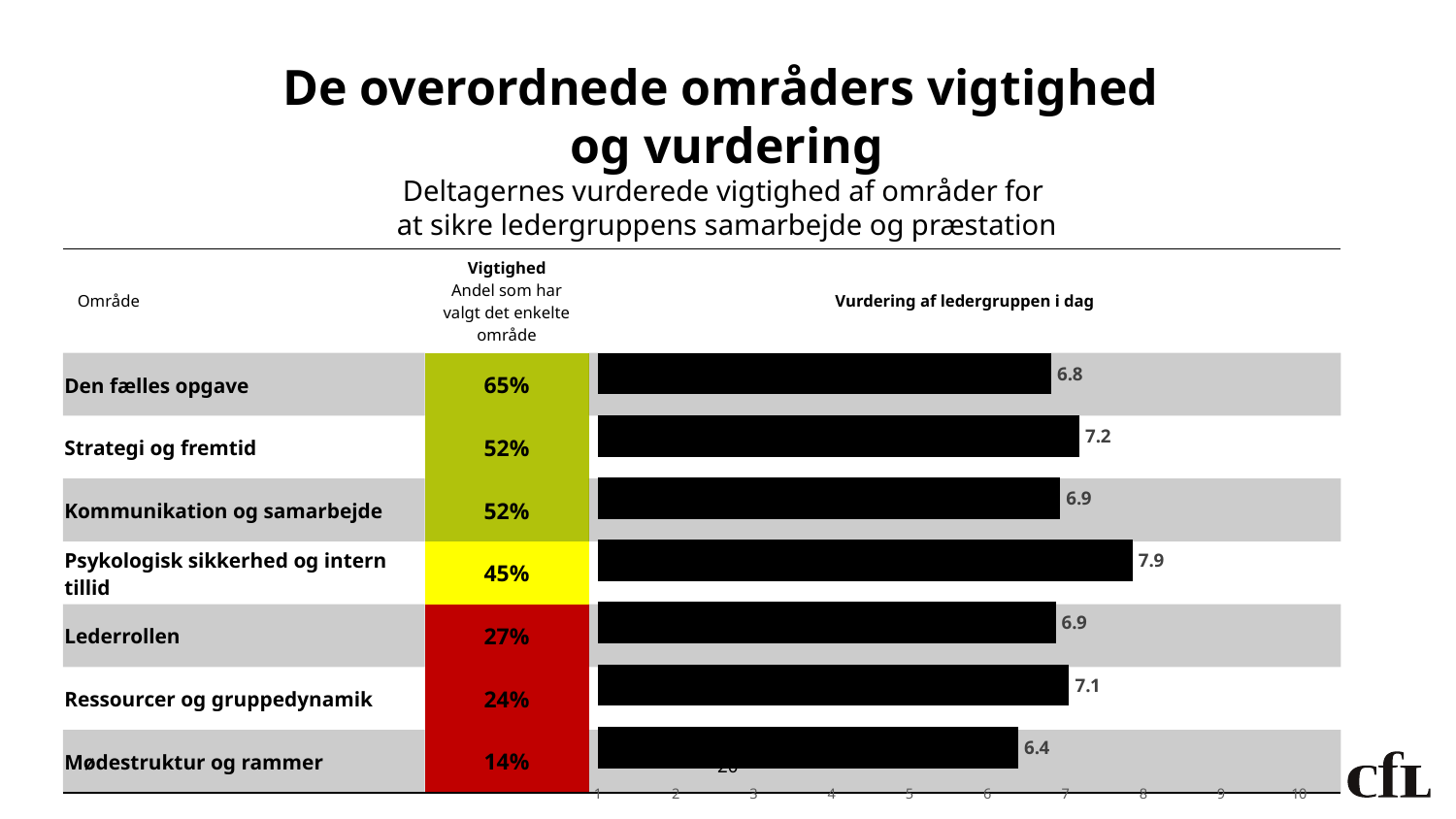
In the chart 'Vurdering af ledergruppen i dag', which has a higher rating: Strategi og fremtid or Den fælles opgave? Strategi og fremtid In the chart 'Vurdering af ledergruppen i dag', which area has the lowest rating? Mødestruktur og rammer In the chart 'Vurdering af ledergruppen i dag', what is the difference between the ratings for Psykologisk sikkerhed og intern tillid and Mødestruktur og rammer? 1.5 In the chart 'Vurdering af ledergruppen i dag', is the value for Mødestruktur og rammer greater or less than 7? less What kind of chart is 'Vurdering af ledergruppen i dag'? bar chart In the chart 'Vurdering af ledergruppen i dag', what is the value for Mødestruktur og rammer? 6.4 In the chart 'Vurdering af ledergruppen i dag', what is the value for Strategi og fremtid? 7.2 In the chart 'Vurdering af ledergruppen i dag', what is the value for Ressourcer og gruppedynamik? 7.1 What is the title of the chart on the right side of the slide? Vurdering af ledergruppen i dag In the chart 'Vurdering af ledergruppen i dag', what is the value for Psykologisk sikkerhed og intern tillid? 7.9 How many areas are plotted in the chart 'Vurdering af ledergruppen i dag'? 7 In the chart 'Vurdering af ledergruppen i dag', which area has the highest rating? Psykologisk sikkerhed og intern tillid